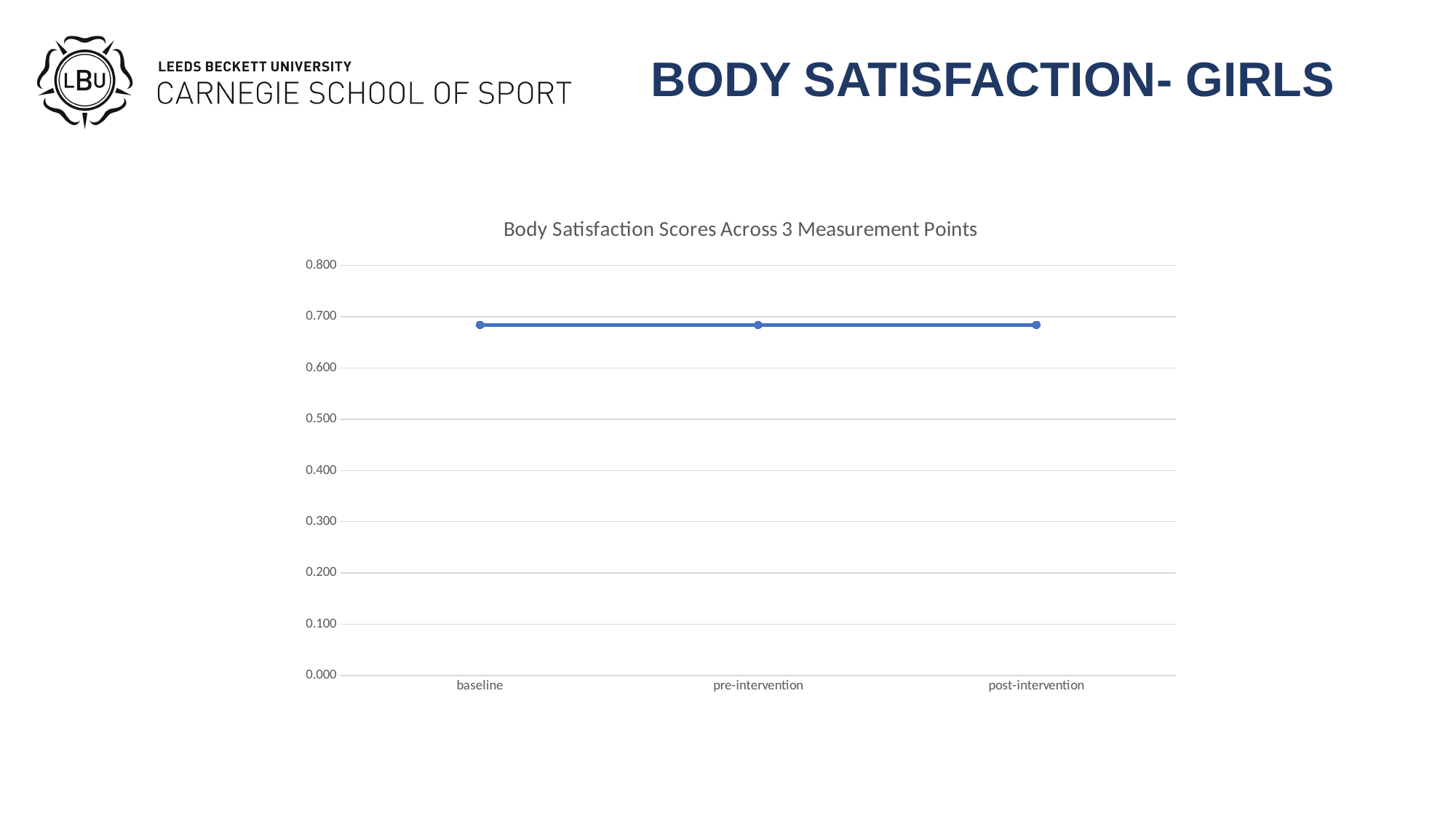
Is the value for baseline greater or less than 0.800? less What are the three categories on the x axis, in order? baseline, pre-intervention, post-intervention What kind of chart is shown on the slide? line chart Do the body satisfaction scores rise, fall, or stay roughly flat from baseline to post-intervention? stay roughly flat Is the value for pre-intervention greater or less than 0.400? greater Is the value for post-intervention greater or less than 0.500? greater How many measurement points are plotted on the x axis? 3 What is the title of the chart? Body Satisfaction Scores Across 3 Measurement Points